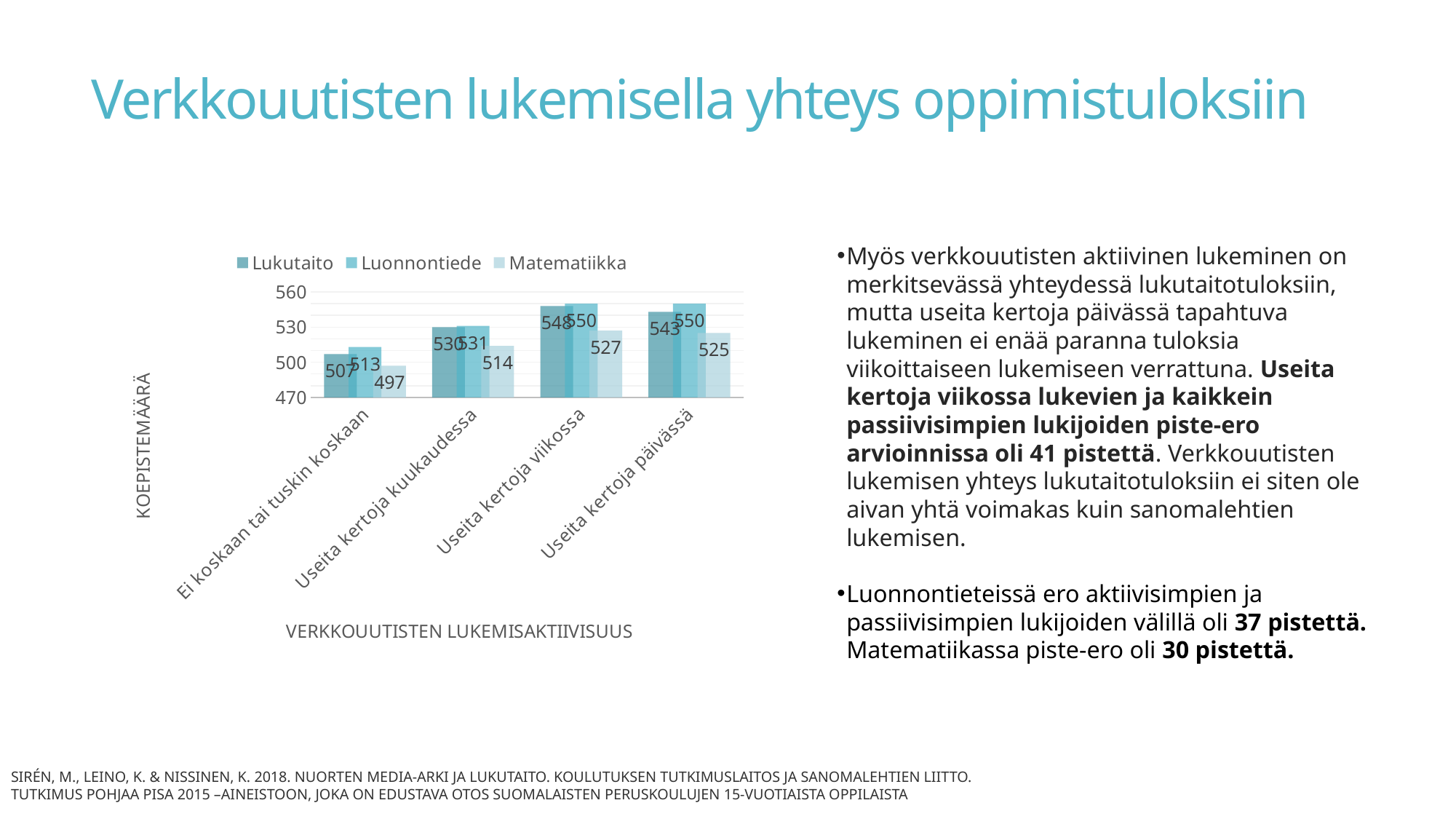
How many series does the chart legend list? 3 What is the difference between the Lukutaito values for "Useita kertoja viikossa" and "Ei koskaan tai tuskin koskaan"? 41 What is the Luonnontiede value for "Ei koskaan tai tuskin koskaan"? 513 How many categories are shown on the x axis of the chart? 4 Which category has the highest Lukutaito value? Useita kertoja viikossa Which is larger: the Lukutaito value for "Useita kertoja kuukaudessa" or the Matematiikka value for "Useita kertoja kuukaudessa"? Lukutaito What type of chart is shown on the slide? Bar chart What is the Lukutaito value for "Useita kertoja päivässä"? 543 What is the difference between the Matematiikka values for "Useita kertoja viikossa" and "Useita kertoja päivässä"? 2 What is the Matematiikka value for "Useita kertoja viikossa"? 527 Which category has the lowest Matematiikka value? Ei koskaan tai tuskin koskaan What is the Matematiikka value for "Ei koskaan tai tuskin koskaan"? 497